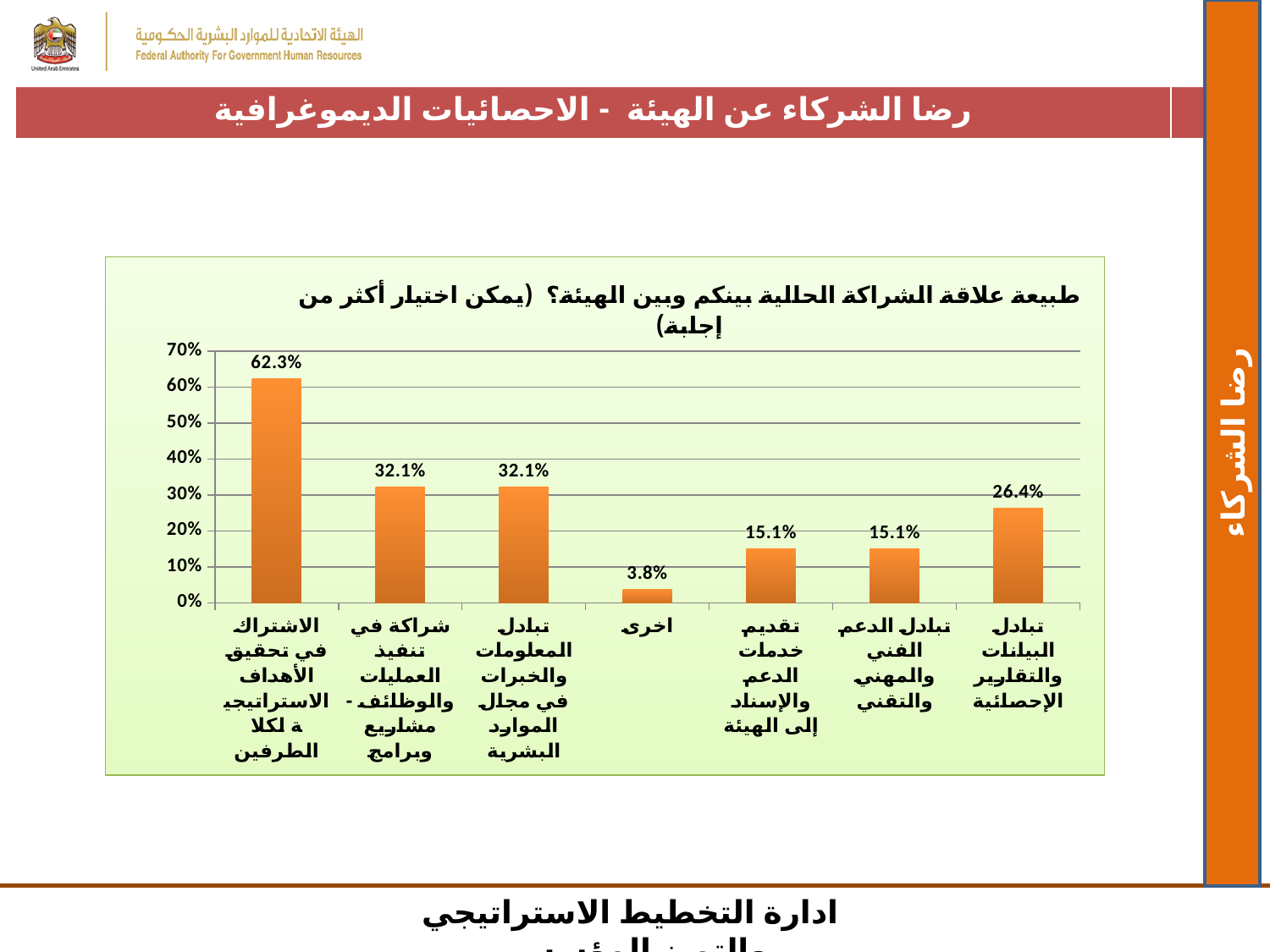
What is the maximum value shown on the y axis? 70% What kind of chart is shown on the slide? bar chart What is the value for "تبادل البيانات والتقارير الإحصائية"? 26.4% How many categories are shown on the x axis? 7 Which category has the highest value? الاشتراك في تحقيق الأهداف الاستراتيجية لكلا الطرفين What is the value for "الاشتراك في تحقيق الأهداف الاستراتيجية لكلا الطرفين"? 62.3% What is the value for "تقديم خدمات الدعم والإسناد إلى الهيئة"? 15.1% What is the difference between the value for "الاشتراك في تحقيق الأهداف الاستراتيجية لكلا الطرفين" and the value for "تبادل البيانات والتقارير الإحصائية"? 35.9% Is the value for "شراكة في تنفيذ العمليات والوظائف - مشاريع وبرامج" greater or less than 30%? greater Which is larger: the value for "تبادل البيانات والتقارير الإحصائية" or the value for "تبادل الدعم الفني والمهني والتقني"? تبادل البيانات والتقارير الإحصائية Which category has the lowest value? اخرى What is the value for "اخرى" (Other)? 3.8%